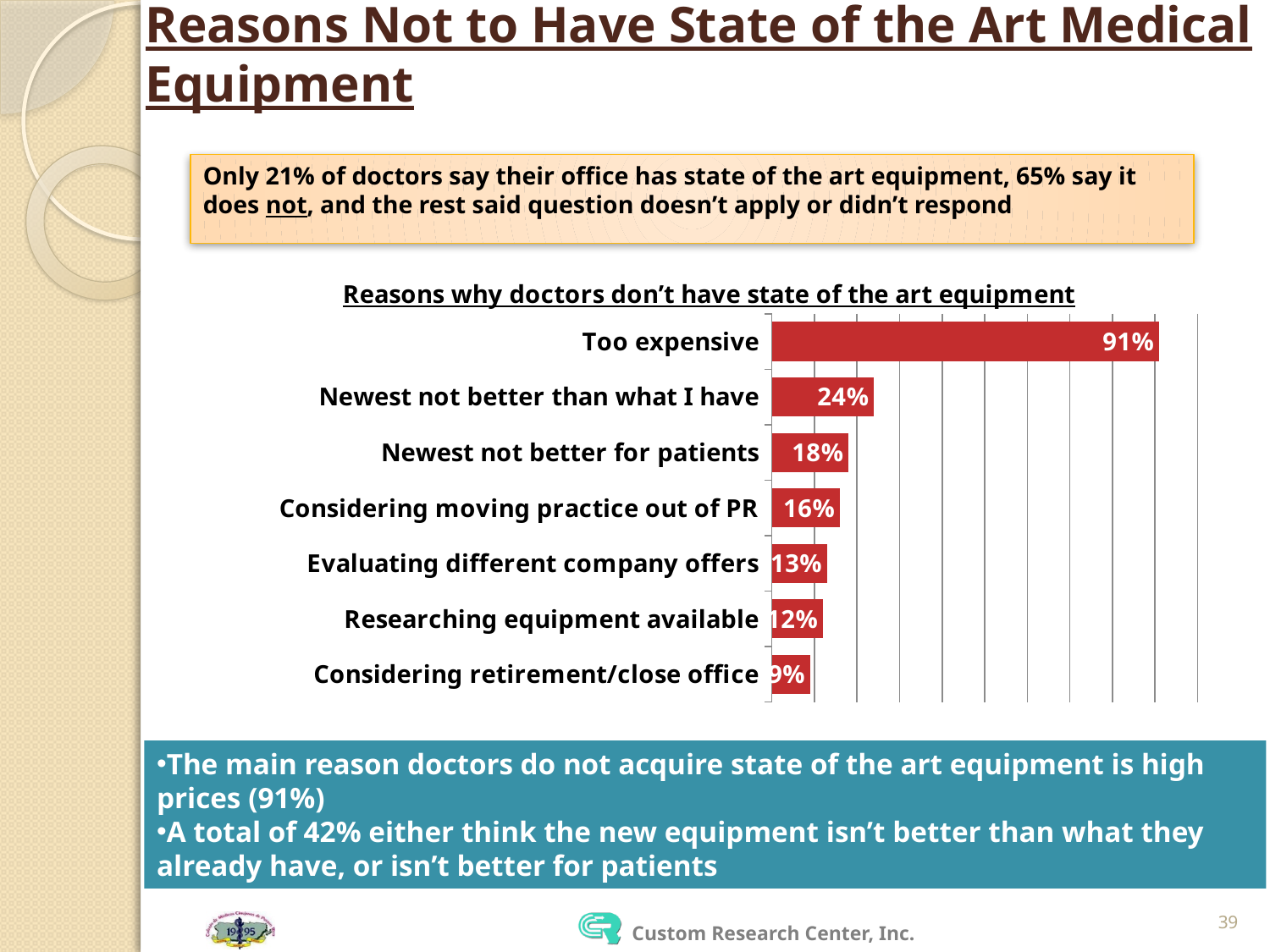
What is the difference between "Newest not better for patients" and "Evaluating different company offers"? 5% What percentage of doctors cite "Too expensive" as a reason for not having state of the art equipment? 91% What is the value for "Newest not better than what I have"? 24% Which is larger: "Newest not better for patients" or "Considering moving practice out of PR"? Newest not better for patients What is the value for "Researching equipment available"? 12% Which reason has the highest percentage? Too expensive How many reasons are shown in the chart? 7 Which reason has the lowest percentage? Considering retirement/close office What is the difference between "Too expensive" and "Newest not better than what I have"? 67% What is the value for "Considering moving practice out of PR"? 16% What is the title of the chart? Reasons why doctors don't have state of the art equipment What kind of chart is used to show the reasons? Bar chart